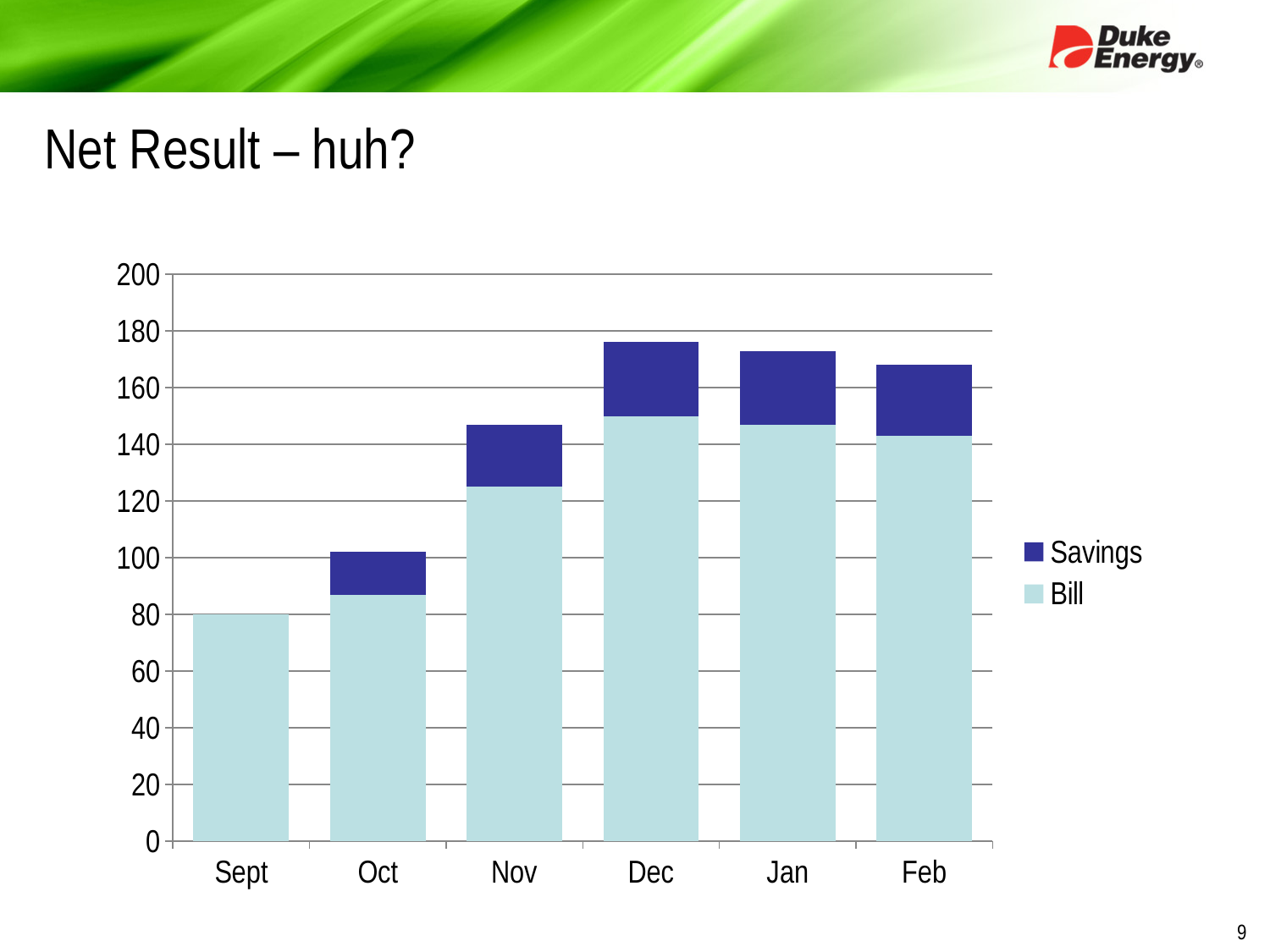
What are the two series named in the legend? Savings and Bill Which month has the lowest total bar? Sept How many months are shown on the x axis? 6 What kind of chart is shown on the slide? stacked bar chart How many series does the legend list? 2 Is the total bar for Dec greater or less than 160? greater Which is larger, the total bar for Oct or the total bar for Nov? Nov Do the total bars rise or fall from Sept to Dec? rise Which month shows no Savings segment at all? Sept Is the total bar for Jan greater or less than 180? less What is the Bill value for Sept? 80 Is the Bill value for Nov greater or less than 120? greater